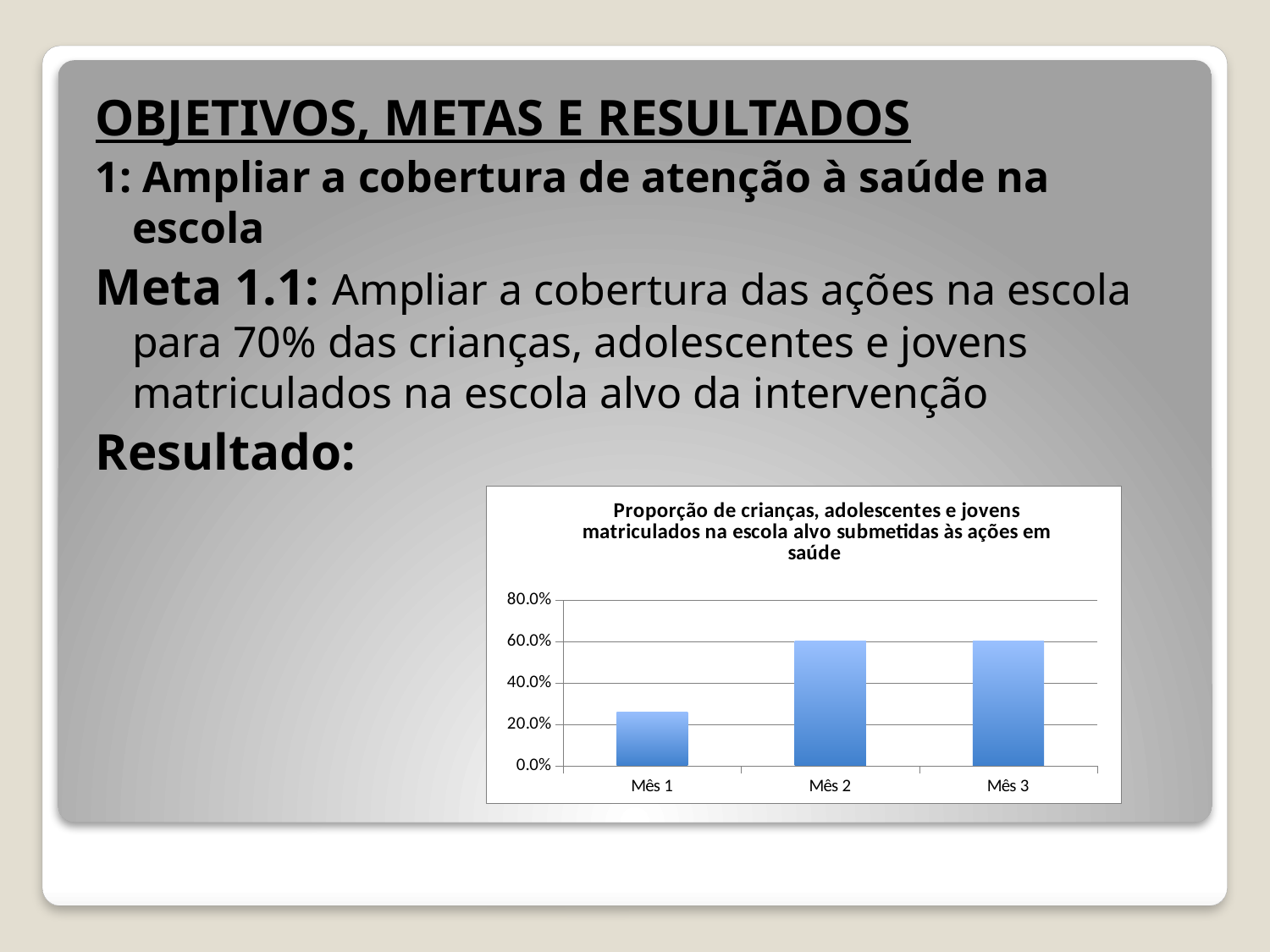
What is the highest value shown on the chart's vertical axis? 80.0% Is the value for Mês 1 greater or less than 20.0%? greater Is the value for Mês 1 greater or less than 40.0%? less Is the value for Mês 2 greater or less than 40.0%? greater What is the title of the chart? Proporção de crianças, adolescentes e jovens matriculados na escola alvo submetidas às ações em saúde Which month has the lowest value on the chart? Mês 1 Does the value rise or fall from Mês 1 to Mês 2? rise Which is larger, the value for Mês 1 or the value for Mês 2? Mês 2 How many categories (months) are plotted on the chart? 3 Which is larger, the value for Mês 3 or the value for Mês 1? Mês 3 What kind of chart is shown on the slide? bar chart